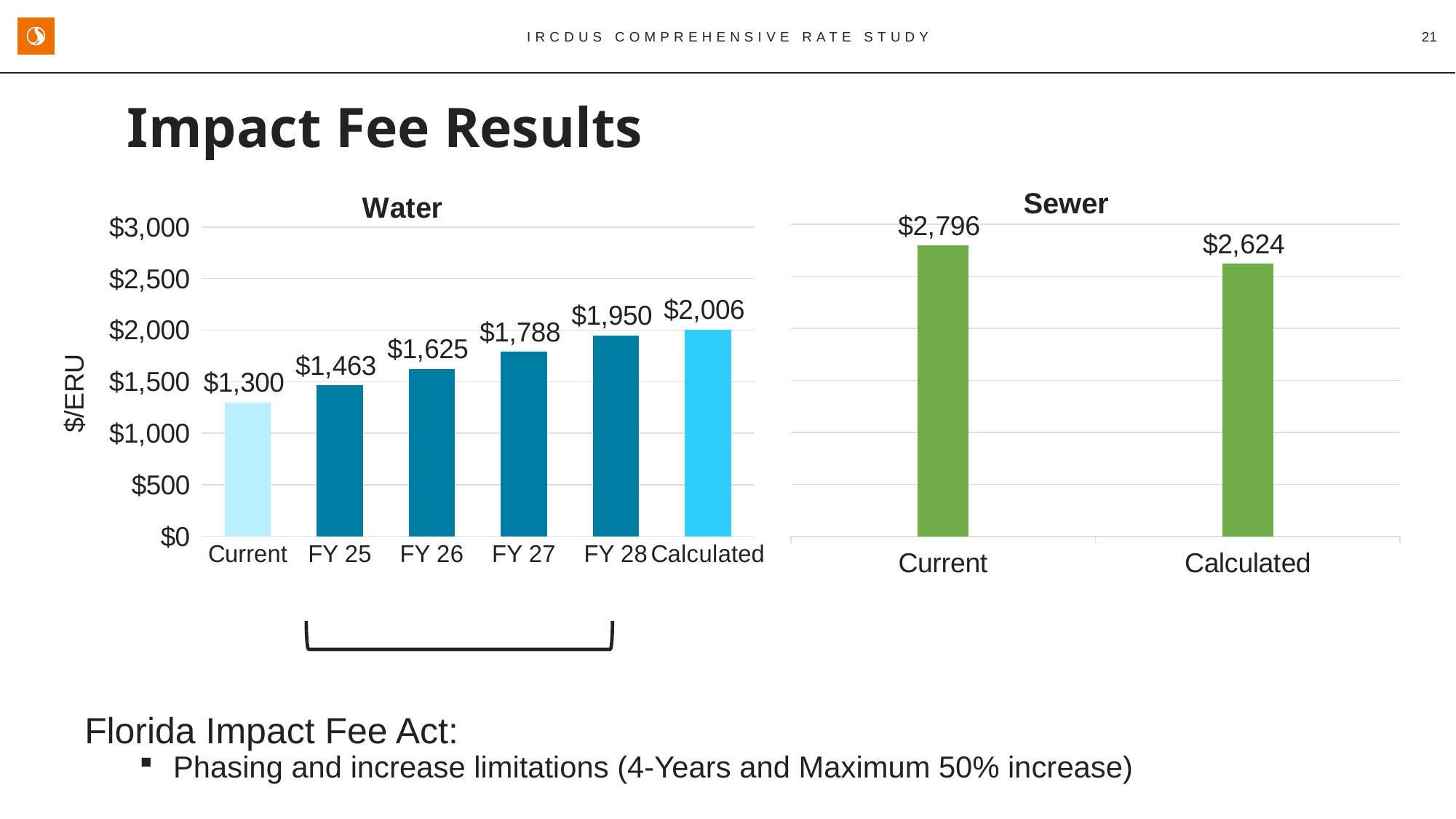
In the Water chart, which category has the highest value? Calculated In the Water chart, what is the Current value? $1,300 How many categories are shown in the Sewer chart? 2 In the Sewer chart, what is the difference between the Current and Calculated values? $172 In the Water chart, which is larger, the value for FY 27 or the value for FY 25? FY 27 How many categories are shown in the Water chart? 6 In the Sewer chart, what is the Calculated value? $2,624 In the Water chart, do the values rise or fall from Current to Calculated? Rise In the Water chart, what is the difference between the Calculated value and the Current value? $706 In the Water chart, what is the value for FY 26? $1,625 What kind of chart is the Water chart? Bar chart In the Sewer chart, which category has the lowest value? Calculated